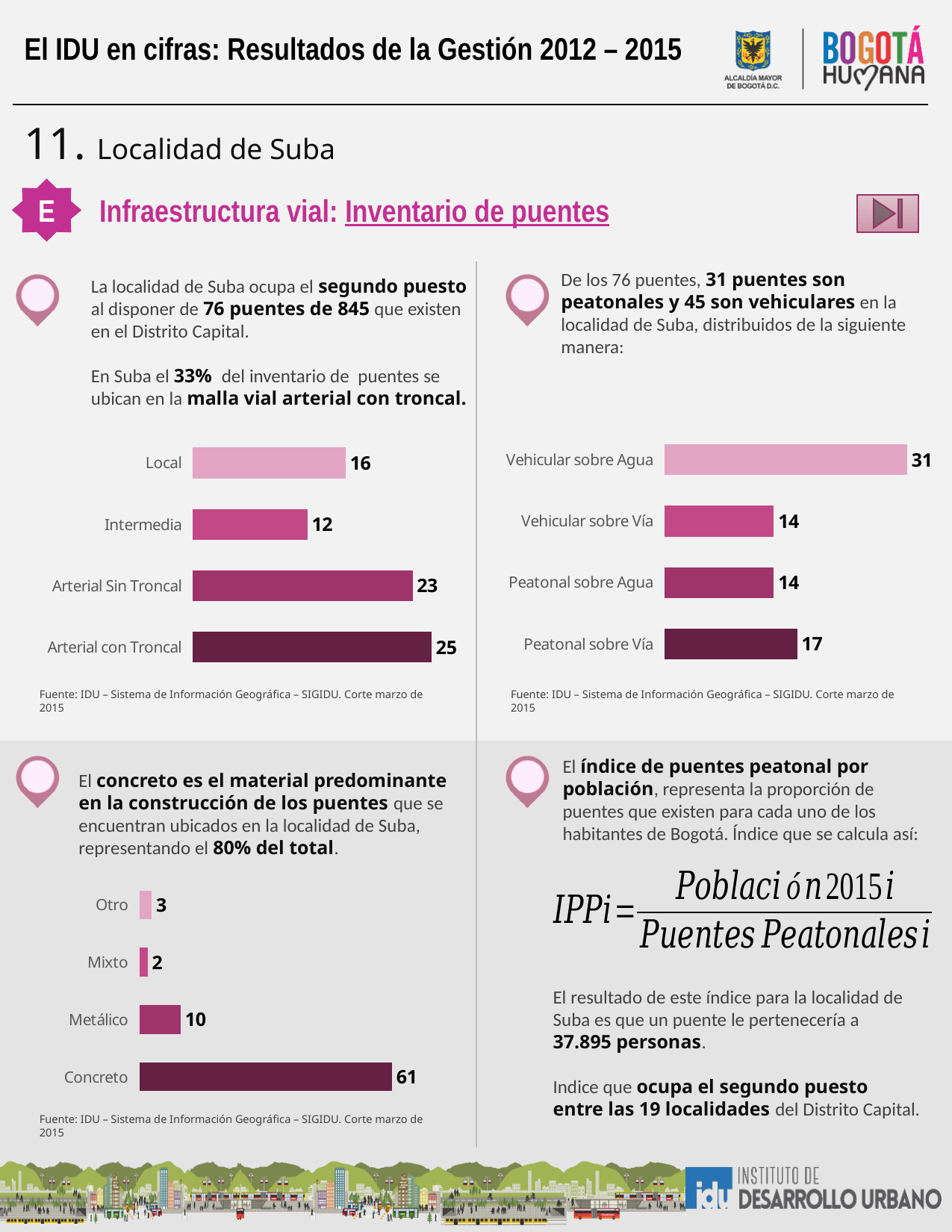
In the bottom-left chart, which category has the lowest value? Mixto In the top-right chart, which is larger: Peatonal sobre Vía or Peatonal sobre Agua? Peatonal sobre Vía In the top-left chart, how many categories are shown? 4 In the bottom-left chart, what is the value for Concreto? 61 What type of chart is the bottom-left chart? Bar chart In the top-left chart, which category has the lowest value? Intermedia In the top-right chart, what is the value for Vehicular sobre Agua? 31 In the top-left chart, what is the difference between Arterial Sin Troncal and Local? 7 In the bottom-left chart, what is the difference between Metálico and Otro? 7 In the top-right chart, what is the difference between Vehicular sobre Agua and Peatonal sobre Vía? 14 In the top-right chart, which category has the highest value? Vehicular sobre Agua In the top-left chart, what is the value for Arterial con Troncal? 25